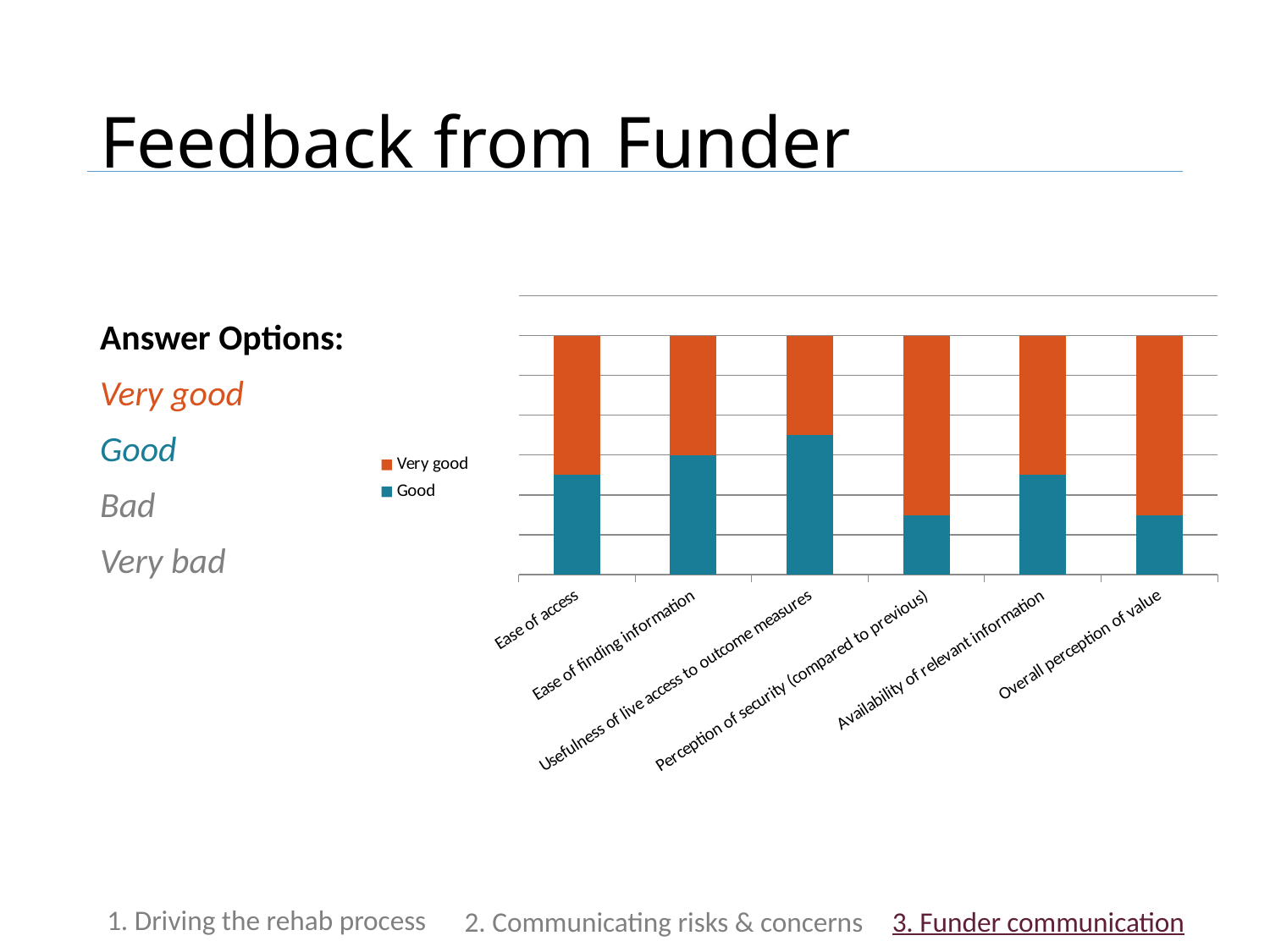
What are the two series named in the chart's legend? Very good and Good Is the 'Very good' segment larger for 'Ease of access' or for 'Usefulness of live access to outcome measures'? Ease of access Which category has the smallest 'Very good' segment? Usefulness of live access to outcome measures Which colour represents the 'Good' series in the chart? Blue Is the 'Very good' segment larger for 'Overall perception of value' or for 'Availability of relevant information'? Overall perception of value Which category has the tallest 'Good' segment? Usefulness of live access to outcome measures How many series does the chart's legend list? 2 What kind of chart is shown on the slide? Stacked bar chart Is the 'Good' segment larger for 'Ease of access' or for 'Usefulness of live access to outcome measures'? Usefulness of live access to outcome measures How many categories are shown along the x axis of the chart? 6